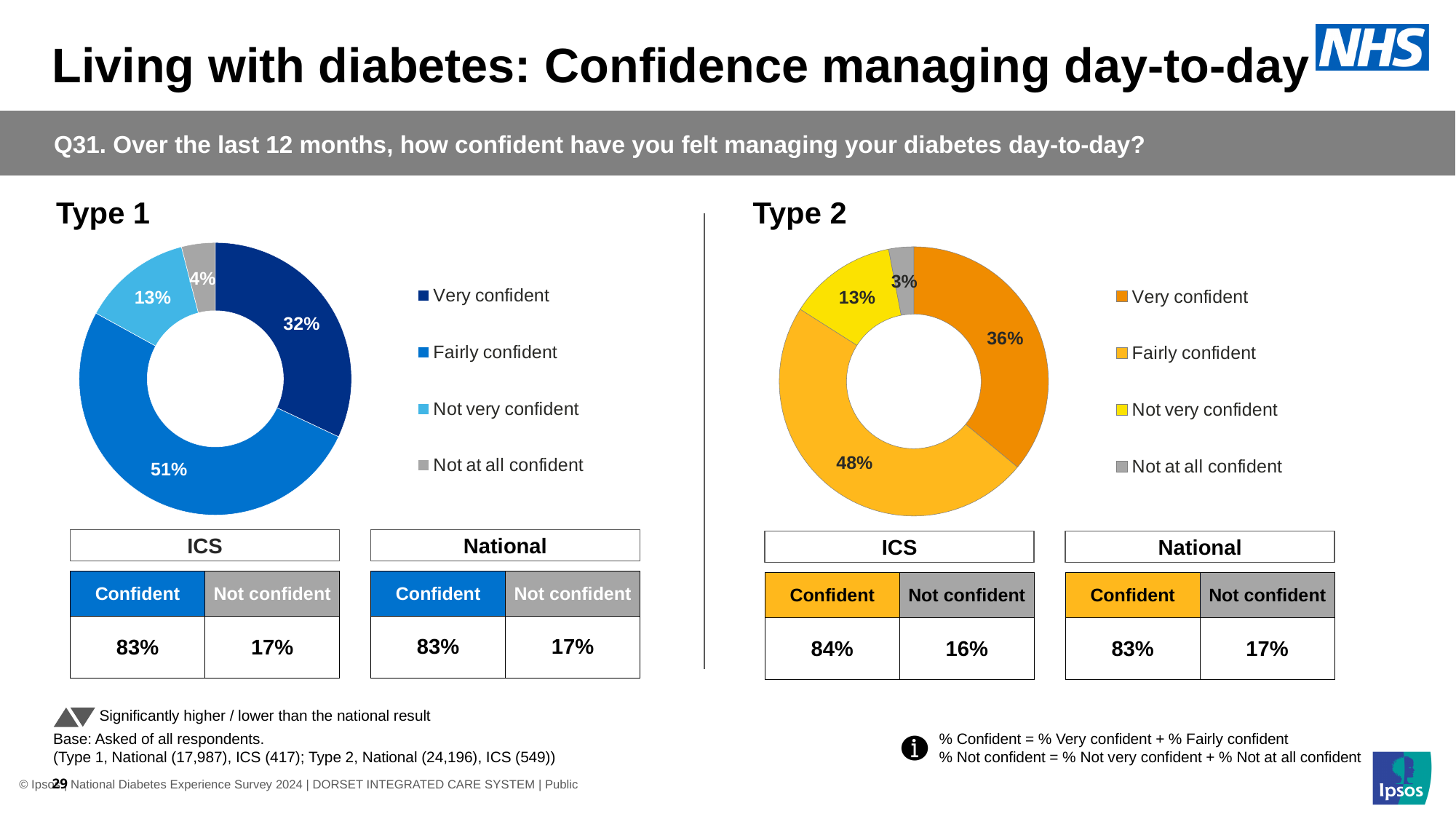
In the Type 2 chart, what percentage of respondents were not very confident? 13% In the Type 1 chart, what percentage of respondents were very confident? 32% In the Type 2 chart, what is the difference in percentage points between fairly confident and very confident? 12 What kind of chart is used for Type 1? Doughnut chart In the Type 1 chart, which category has the largest share? Fairly confident In the Type 1 chart, which is larger: the share for very confident or the share for not very confident? Very confident How many categories does the Type 2 chart show? 4 In the Type 2 chart, which category has the smallest share? Not at all confident In the Type 2 chart, what colour represents the fairly confident category? Yellow-orange In the Type 2 chart, what percentage of respondents were not at all confident? 3% In the Type 1 chart, what is the combined share of very confident and fairly confident? 83% In the Type 1 chart, what percentage of respondents were fairly confident? 51%